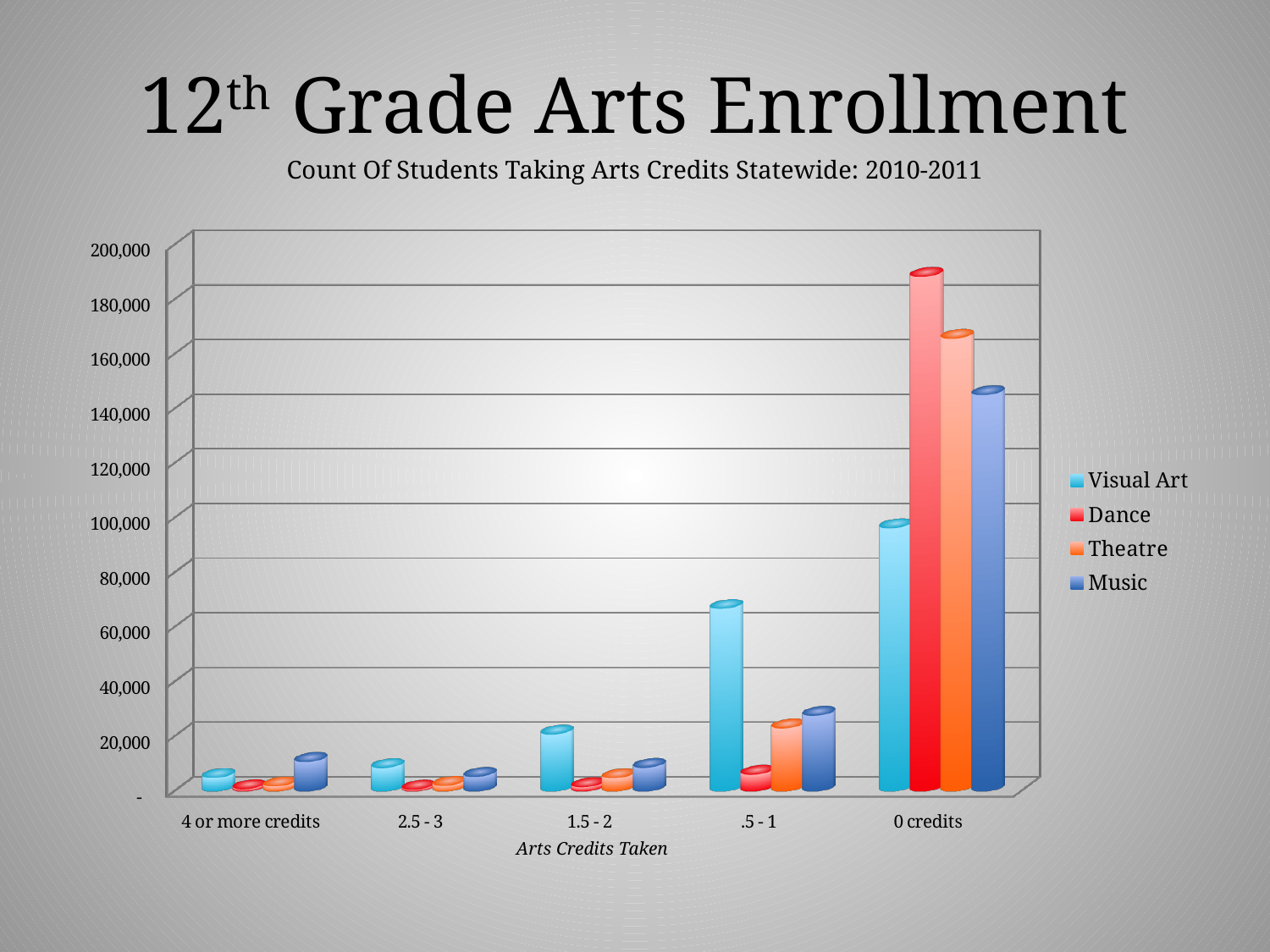
Is the value for Visual Art in the .5 - 1 category greater or less than 60,000? greater Which is larger in the .5 - 1 category, Visual Art or Music? Visual Art How many series does the legend list? 4 What kind of chart is shown on the slide? bar chart Which series has the tallest bar in the 0 credits category? Dance What is the label of the x axis? Arts Credits Taken Is the value for Visual Art in the 0 credits category greater or less than 100,000? less Is the value for Dance in the 0 credits category greater or less than 180,000? greater How many categories are shown on the x axis? 5 Which is larger in the 0 credits category, Theatre or Music? Theatre Do the Visual Art values rise or fall moving along the x axis from 4 or more credits to 0 credits? rise Which series has the shortest bar in the .5 - 1 category? Dance